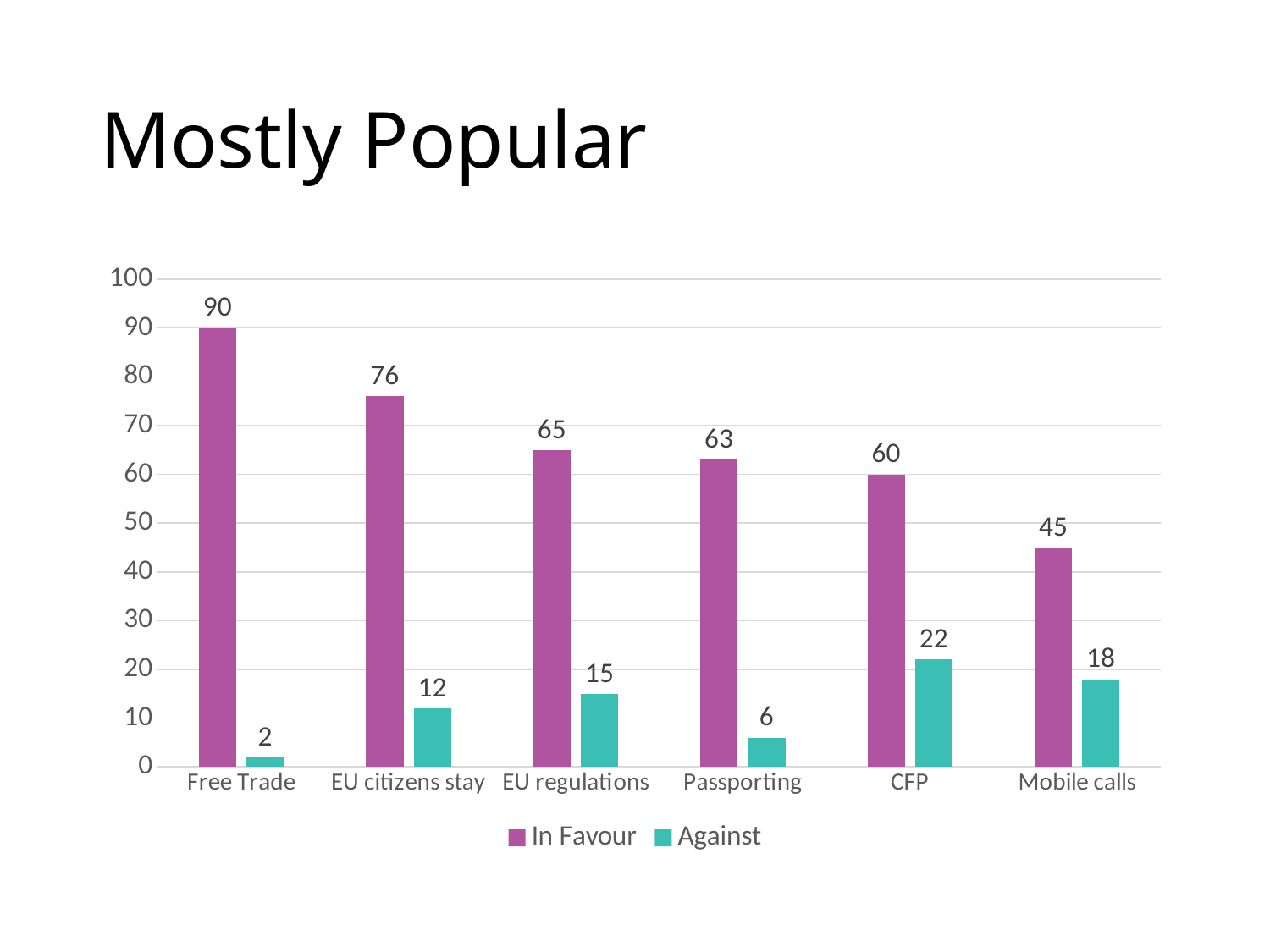
What is the difference between the In Favour and Against values for Mobile calls? 27 Which category has the highest In Favour value? Free Trade Which is larger, the Against value for EU regulations or the Against value for Passporting? EU regulations What is the title of the slide? Mostly Popular What is the In Favour value for Passporting? 63 What is the Against value for CFP? 22 How many series does the legend list? 2 Which category has the lowest In Favour value? Mobile calls What is the In Favour value for Free Trade? 90 Which category has the lowest Against value? Free Trade How many categories are shown on the x axis? 6 What kind of chart is shown on the slide? Bar chart